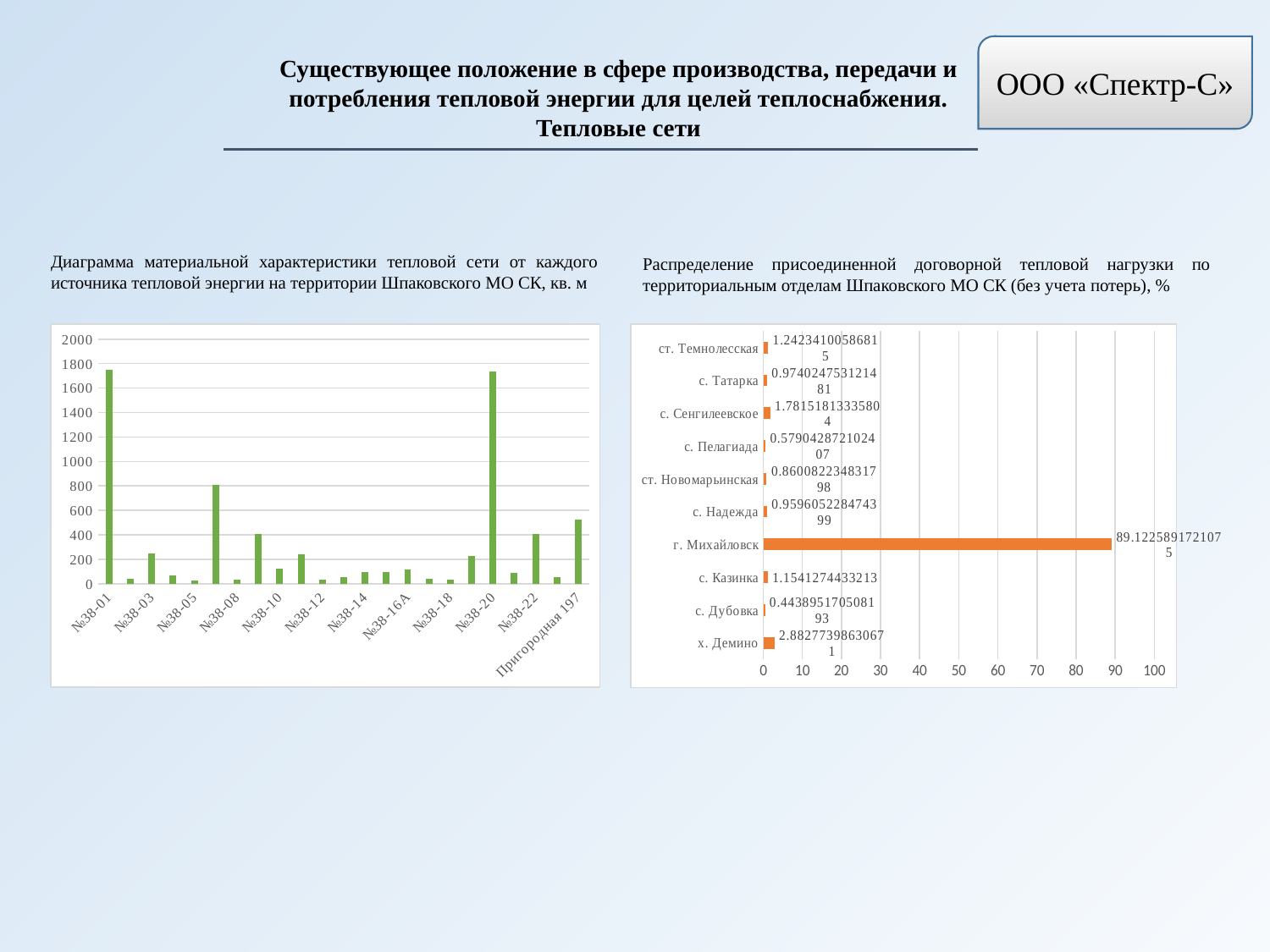
In the right chart (Распределение присоединенной договорной тепловой нагрузки), what is the value for с. Сенгилеевское? 1.78151813335804 In the left chart (Диаграмма материальной характеристики тепловой сети), is the value for Пригородная 197 greater or less than 400? greater What kind of chart is the left chart (Диаграмма материальной характеристики тепловой сети)? bar chart In the right chart (Распределение присоединенной договорной тепловой нагрузки), what is the value for с. Дубовка? 0.443895170508193 In the right chart (Распределение присоединенной договорной тепловой нагрузки), which territorial department has the lowest value? с. Дубовка In the right chart (Распределение присоединенной договорной тепловой нагрузки), what is the value for г. Михайловск? 89.1225891721075 In the right chart (Распределение присоединенной договорной тепловой нагрузки), is the value for г. Михайловск greater or less than 80? greater In the right chart (Распределение присоединенной договорной тепловой нагрузки), how many territorial departments are plotted? 10 In the left chart (Диаграмма материальной характеристики тепловой сети), is the value for №38-01 greater or less than 1600? greater In the right chart (Распределение присоединенной договорной тепловой нагрузки), what is the value for х. Демино? 2.88277398630671 In the right chart (Распределение присоединенной договорной тепловой нагрузки), which is larger: the value for х. Демино or for с. Сенгилеевское? х. Демино In the right chart (Распределение присоединенной договорной тепловой нагрузки), which territorial department has the highest value? г. Михайловск